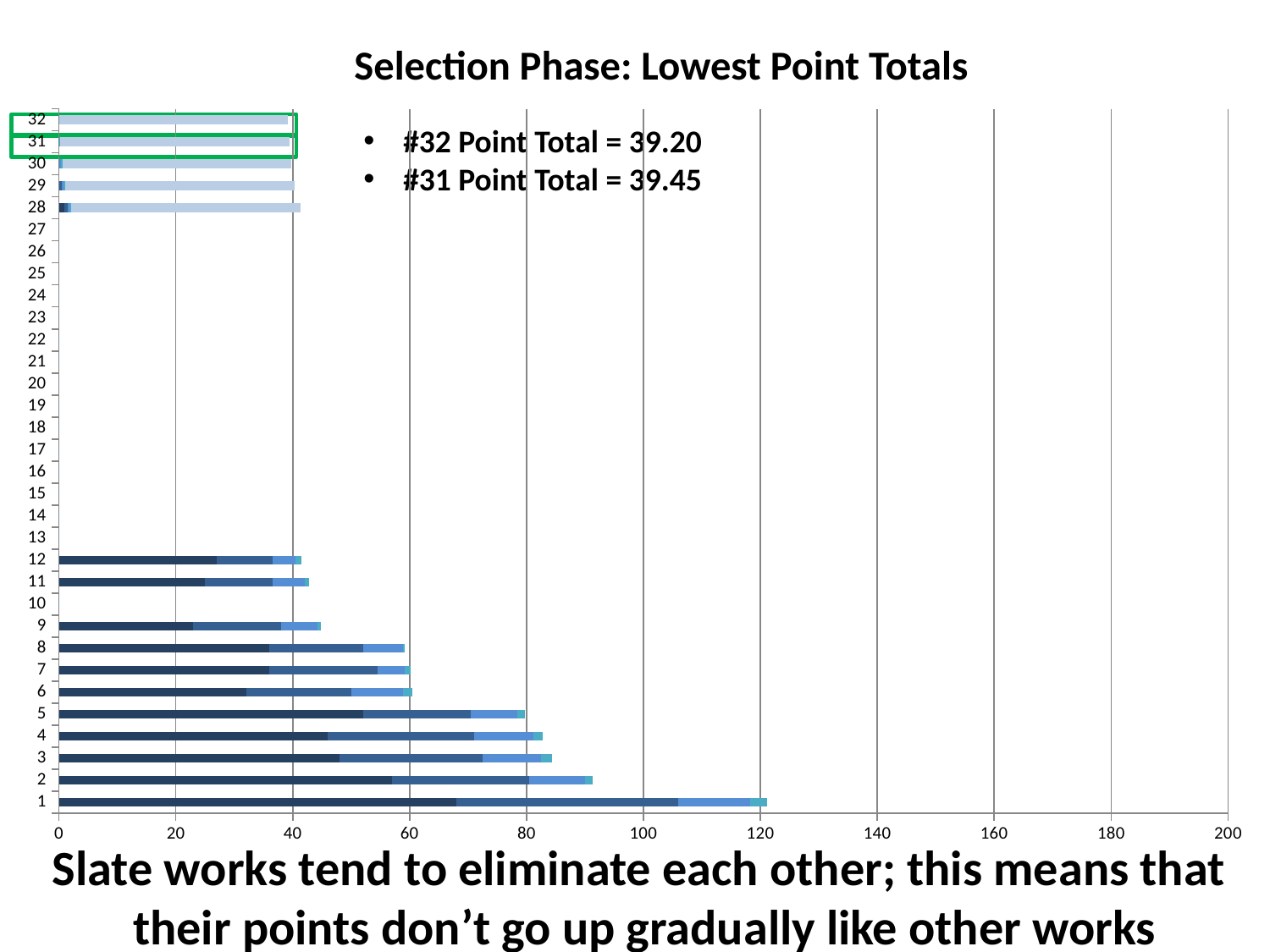
What is the difference between the point totals of #31 and #32? 0.25 Which category has the longest bar in the chart? 1 What kind of chart is shown on the slide? bar chart Is the total for category 9 greater or less than 40? greater What is the title of the chart? Selection Phase: Lowest Point Totals How many categories are labeled on the vertical axis? 32 Which has the lower point total, #31 or #32? #32 Which bar is longer, category 8 or category 9? 8 What is the point total for #31 according to the slide? 39.45 Is the total for category 1 greater or less than 100? greater What is the point total for #32 according to the slide? 39.20 Is the total for category 2 greater or less than 80? greater